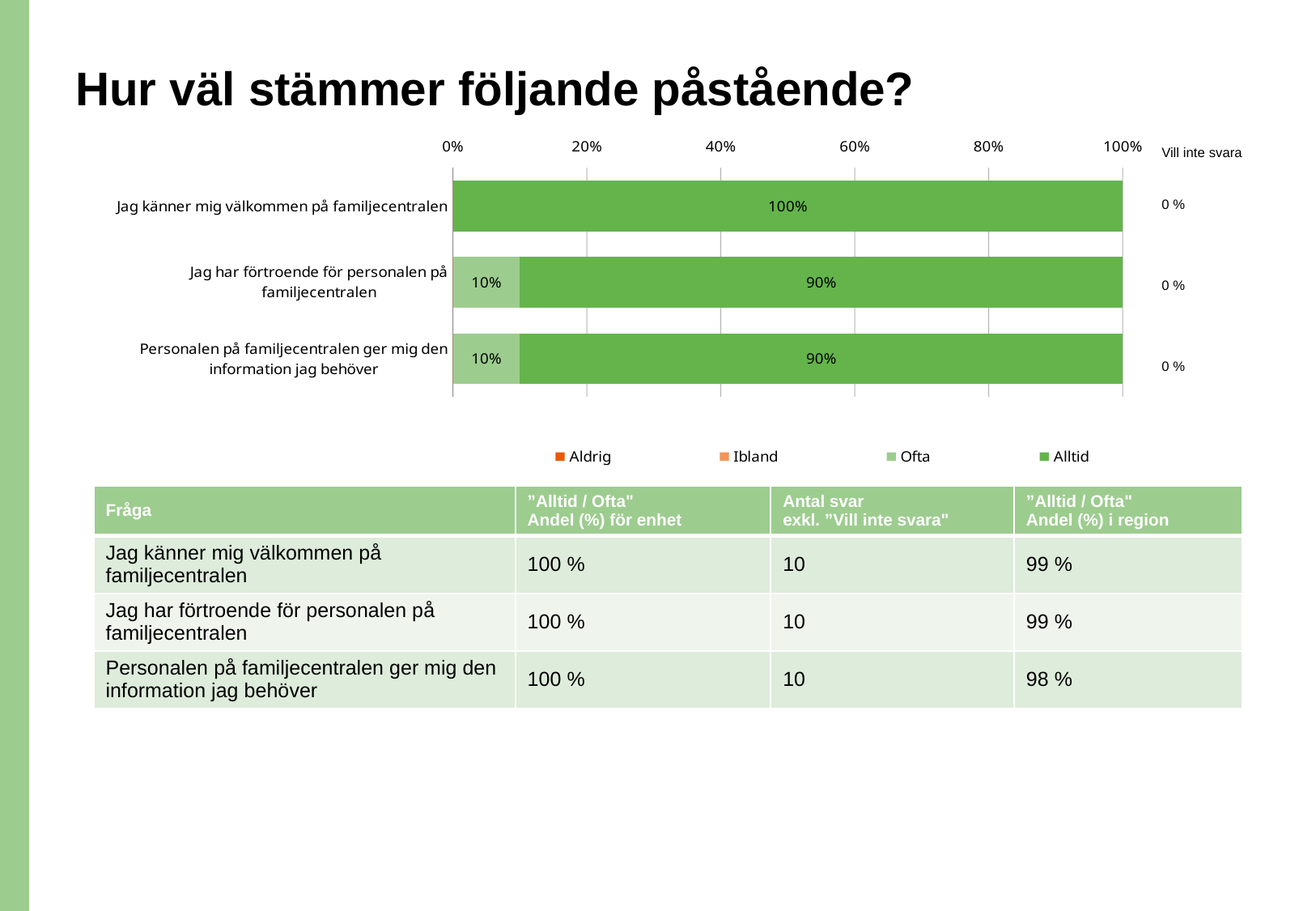
What kind of chart is shown on the slide? bar chart What is the "Vill inte svara" value shown next to the bar for "Jag känner mig välkommen på familjecentralen"? 0 % Which is larger for "Jag har förtroende för personalen på familjecentralen": the "Ofta" value or the "Alltid" value? Alltid Which statement has the highest "Alltid" value? Jag känner mig välkommen på familjecentralen What is the "Alltid" value for "Jag har förtroende för personalen på familjecentralen"? 90% What is the "Alltid" value for "Jag känner mig välkommen på familjecentralen"? 100% What is the "Ofta" value for "Personalen på familjecentralen ger mig den information jag behöver"? 10% How many series does the chart legend list? 4 What is the total of the stacked bar for "Personalen på familjecentralen ger mig den information jag behöver"? 100% What is the difference between the "Alltid" value for "Jag känner mig välkommen på familjecentralen" and the "Alltid" value for "Jag har förtroende för personalen på familjecentralen"? 10% How many categories (statements) are plotted in the chart? 3 What are the four legend entries of the chart? Aldrig, Ibland, Ofta, Alltid